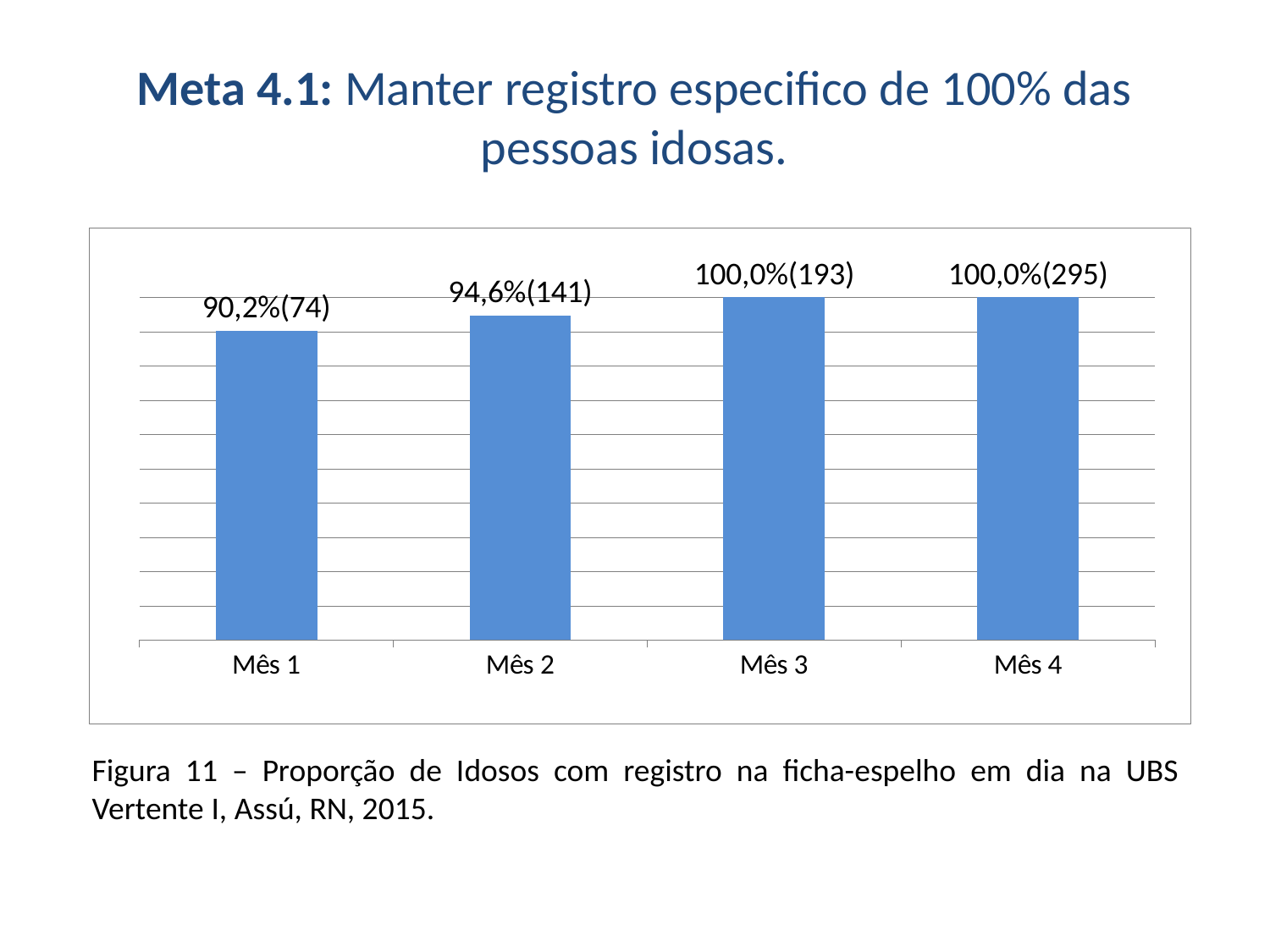
How many months (categories) are shown on the x axis? 4 What is the number in parentheses shown for Mês 3? 193 What figure number is given in the caption below the chart? Figura 11 Do the percentages rise or fall from Mês 1 to Mês 4? Rise What is the difference between the counts in parentheses for Mês 4 and Mês 3? 102 Which has a higher percentage, Mês 1 or Mês 2? Mês 2 What percentage is shown for Mês 2? 94,6% What is the difference in percentage points between Mês 2 and Mês 1? 4,4 What is the data label shown for Mês 4? 100,0%(295) What is the data label shown for Mês 1? 90,2%(74) Which month has the lowest percentage? Mês 1 What kind of chart is shown on the slide? Bar chart